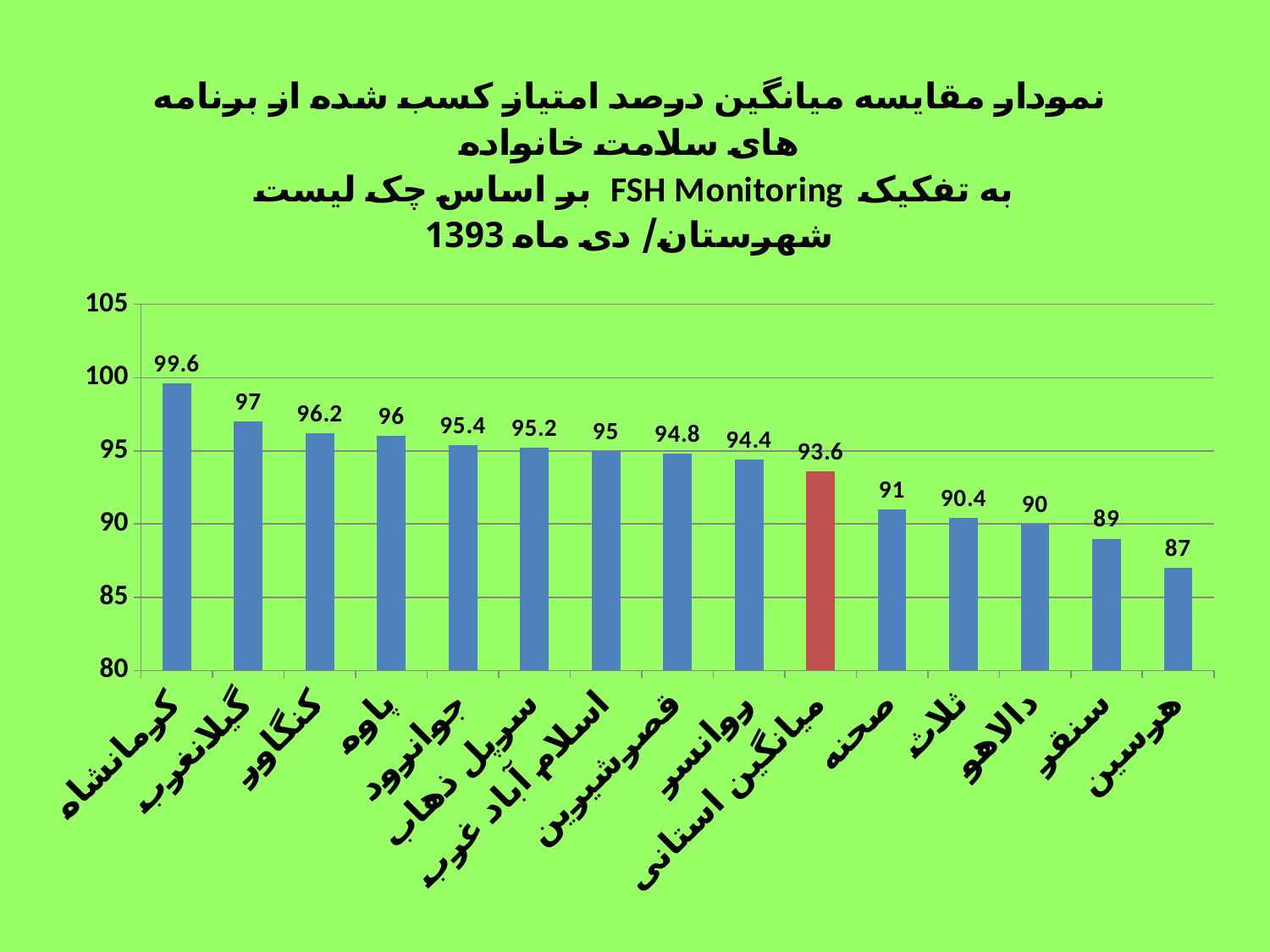
Which bar is coloured red instead of blue? میانگین استانی What is the difference between the values for کرمانشاه and هرسین? 12.6 Which category has the highest value? کرمانشاه What kind of chart is shown on the slide? bar chart Which category has the lowest value? هرسین How many bars are plotted in the chart? 15 What value is shown for میانگین استانی? 93.6 What value is shown for کرمانشاه? 99.6 Which is larger, the value for پاوه or the value for دالاهو? پاوه What is the difference between the values for گیلانغرب and صحنه? 6 What value is shown for ثلاث? 90.4 What value is shown for سرپل ذهاب? 95.2